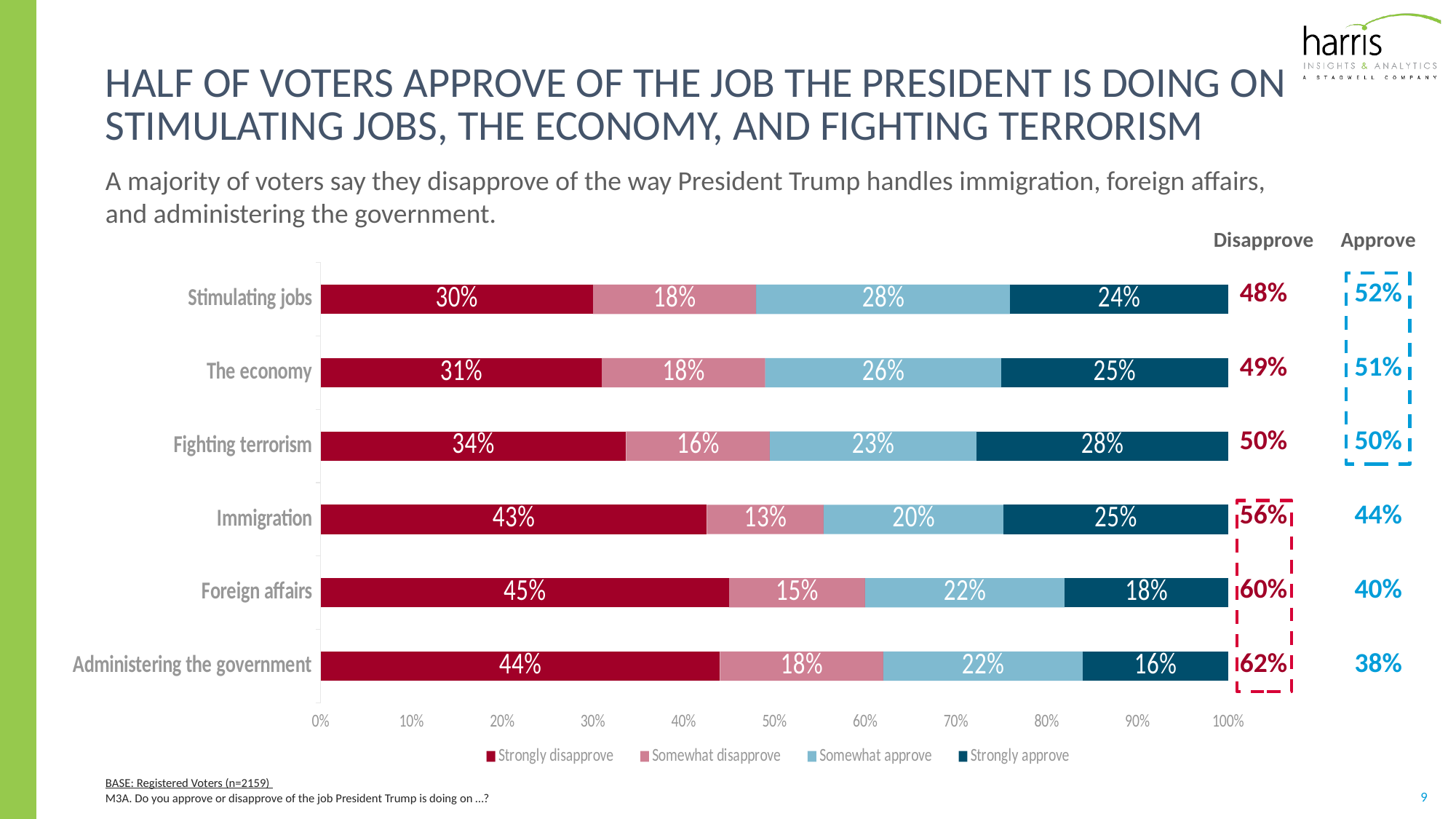
How many categories are shown on the chart? 6 What percentage of voters strongly disapprove of the job the President is doing on Immigration? 43% What kind of chart is shown on the slide? Stacked bar chart What colour represents Strongly approve in the legend? Dark blue What is the total Disapprove percentage shown for Foreign affairs? 60% Which is larger: the Somewhat approve value for Stimulating jobs or for Immigration? Stimulating jobs Which category has the highest Strongly disapprove value? Foreign affairs What percentage of voters somewhat approve of the job the President is doing on The economy? 26% What is the difference between the Strongly disapprove values for Administering the government and Stimulating jobs? 14% How many series does the legend list? 4 Which category has the lowest Strongly approve value? Administering the government What percentage of voters strongly approve of the job the President is doing on Fighting terrorism? 28%